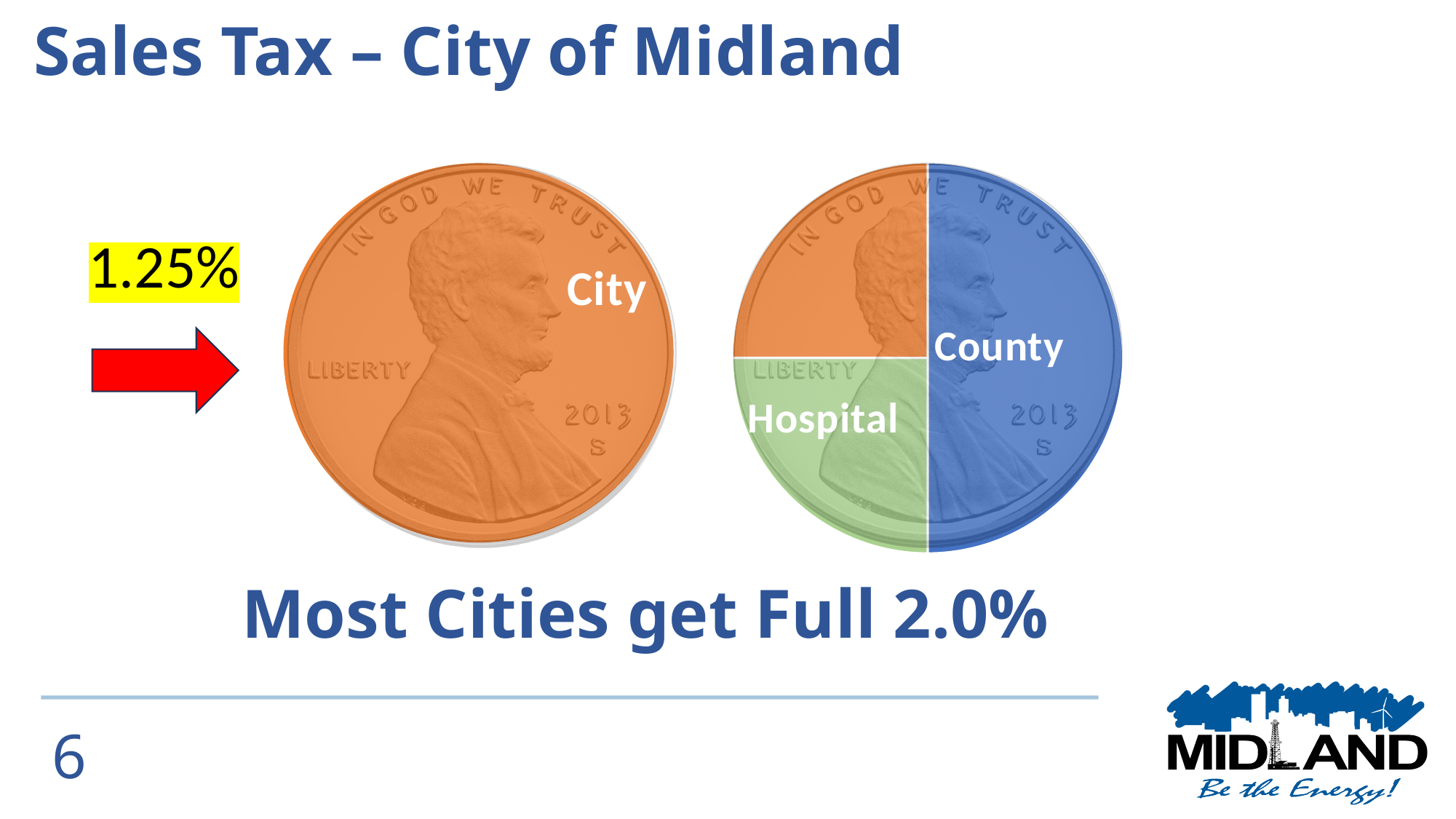
What is the title of the slide? Sales Tax – City of Midland What are the labels of the segments on the right-hand penny? Hospital, County On the right-hand penny, which segment is the largest? County What label appears on the left-hand, fully orange penny? City What percentage is highlighted next to the red arrow pointing at the left-hand penny? 1.25% On the right-hand penny, which is larger, the County segment or the Hospital segment? County According to the text below the pennies, what full percentage do most cities get? 2.0% How many segments is the right-hand penny divided into? 3 What colour is the County segment on the right-hand penny? Blue On the right-hand penny, which is larger, the County segment or the City segment? County